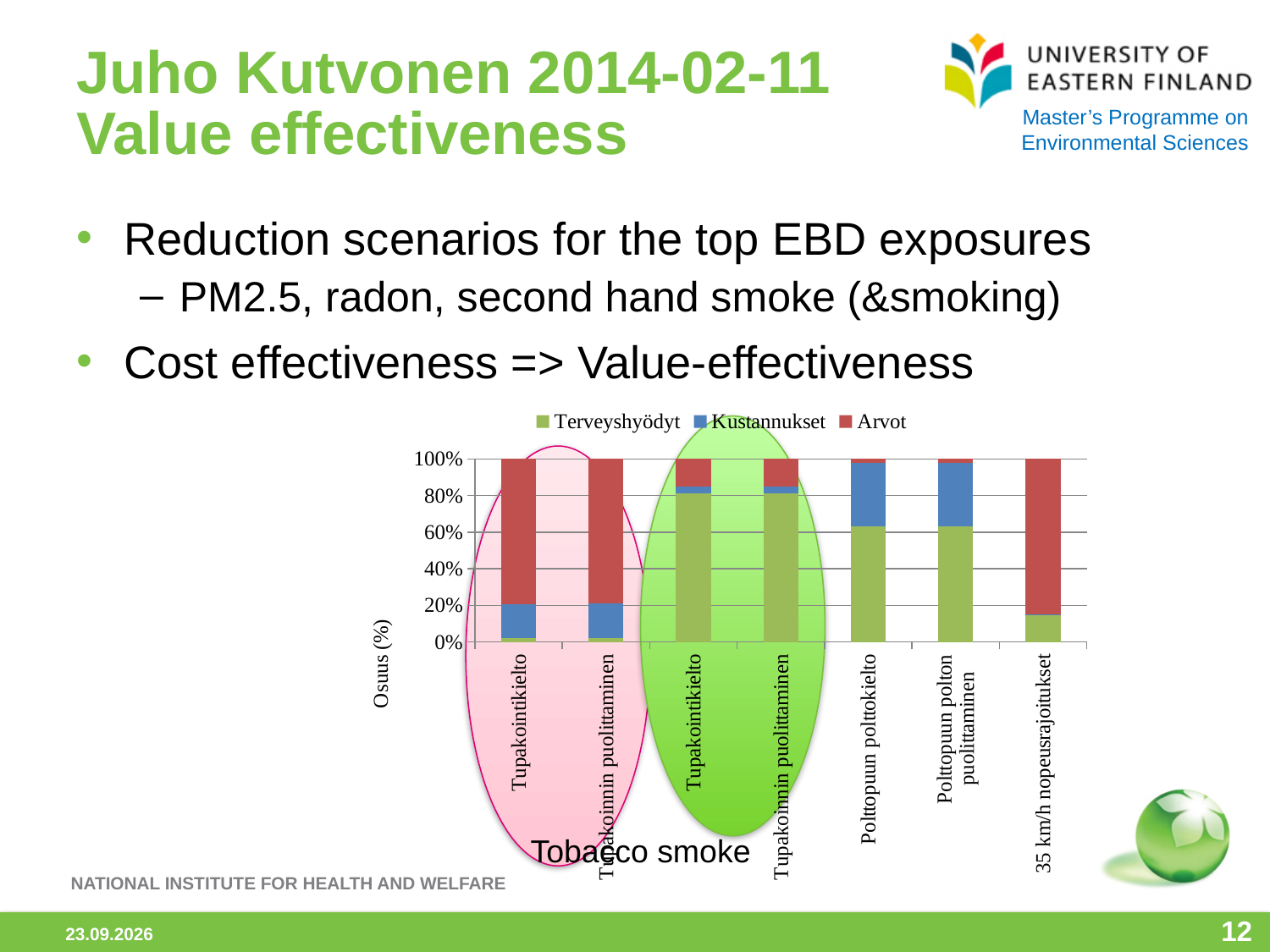
What is the title of the vertical axis of the chart? Osuus (%) How many bars (categories) are plotted in the chart? 7 Is the Arvot share for Polttopuun polttokielto greater or less than 20%? less Which has the larger Arvot share: 35 km/h nopeusrajoitukset or Polttopuun polton puolittaminen? 35 km/h nopeusrajoitukset Is the Terveyshyödyt share for Polttopuun polttokielto greater or less than 40%? greater Which series is listed first in the chart legend? Terveyshyödyt Is the Arvot share for the first Tupakointikielto bar greater or less than 60%? greater What kind of chart is shown on the slide? Stacked bar chart How many series does the chart legend list? 3 Which has the larger Terveyshyödyt share: Polttopuun polttokielto or 35 km/h nopeusrajoitukset? Polttopuun polttokielto